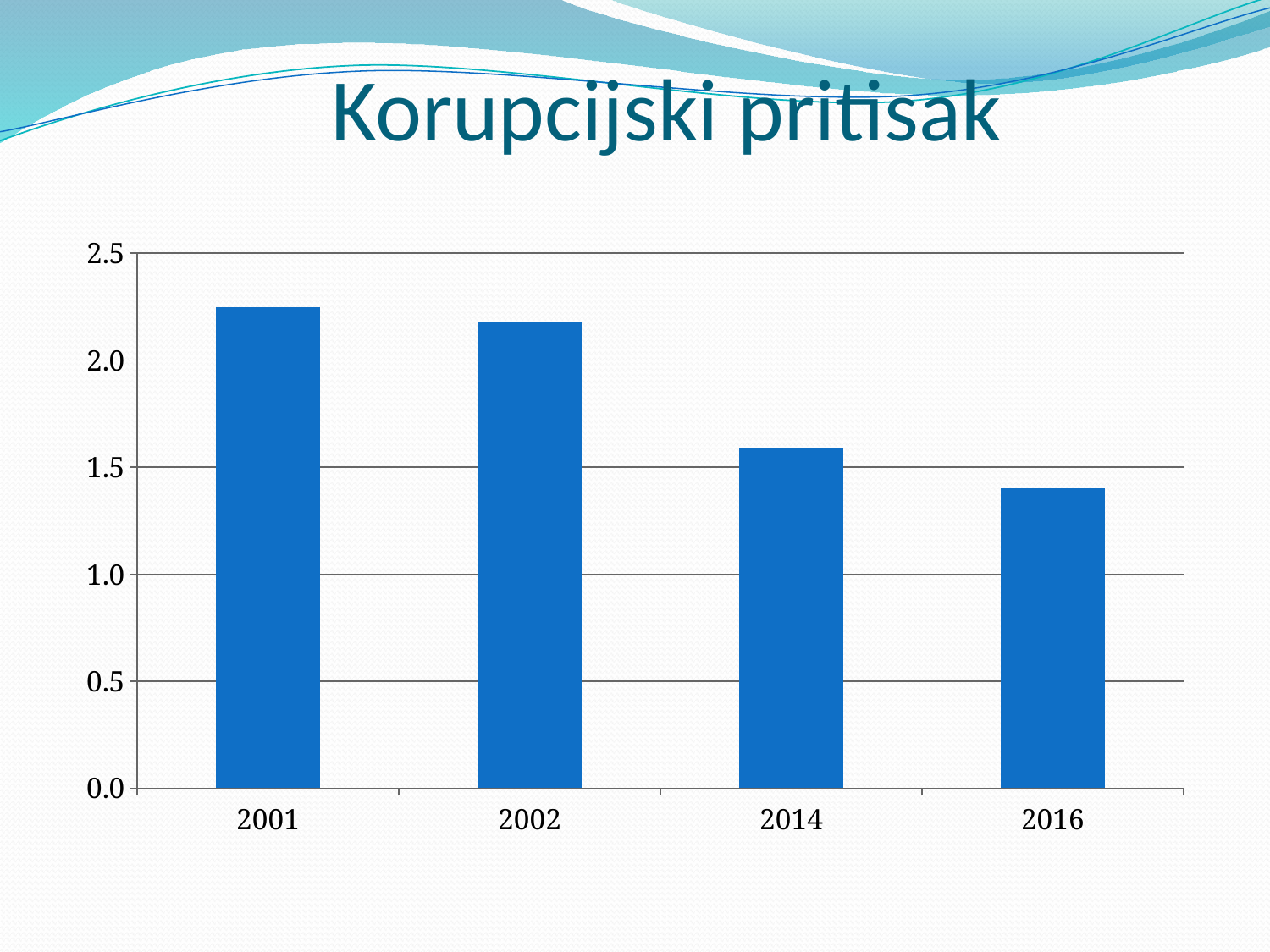
How many bars (categories) does the chart show? 4 Which year has the highest value? 2001 What kind of chart is shown on the slide? bar chart Which year has the lowest value? 2016 Is the value for 2002 greater or less than 2.0? greater Is the value for 2014 greater or less than 1.5? greater Do the values rise or fall from 2001 to 2016? fall Is the value for 2016 greater or less than 1.5? less What is the highest value shown on the vertical axis? 2.5 What is the title of the chart? Korupcijski pritisak Which is larger, the value for 2002 or the value for 2014? 2002